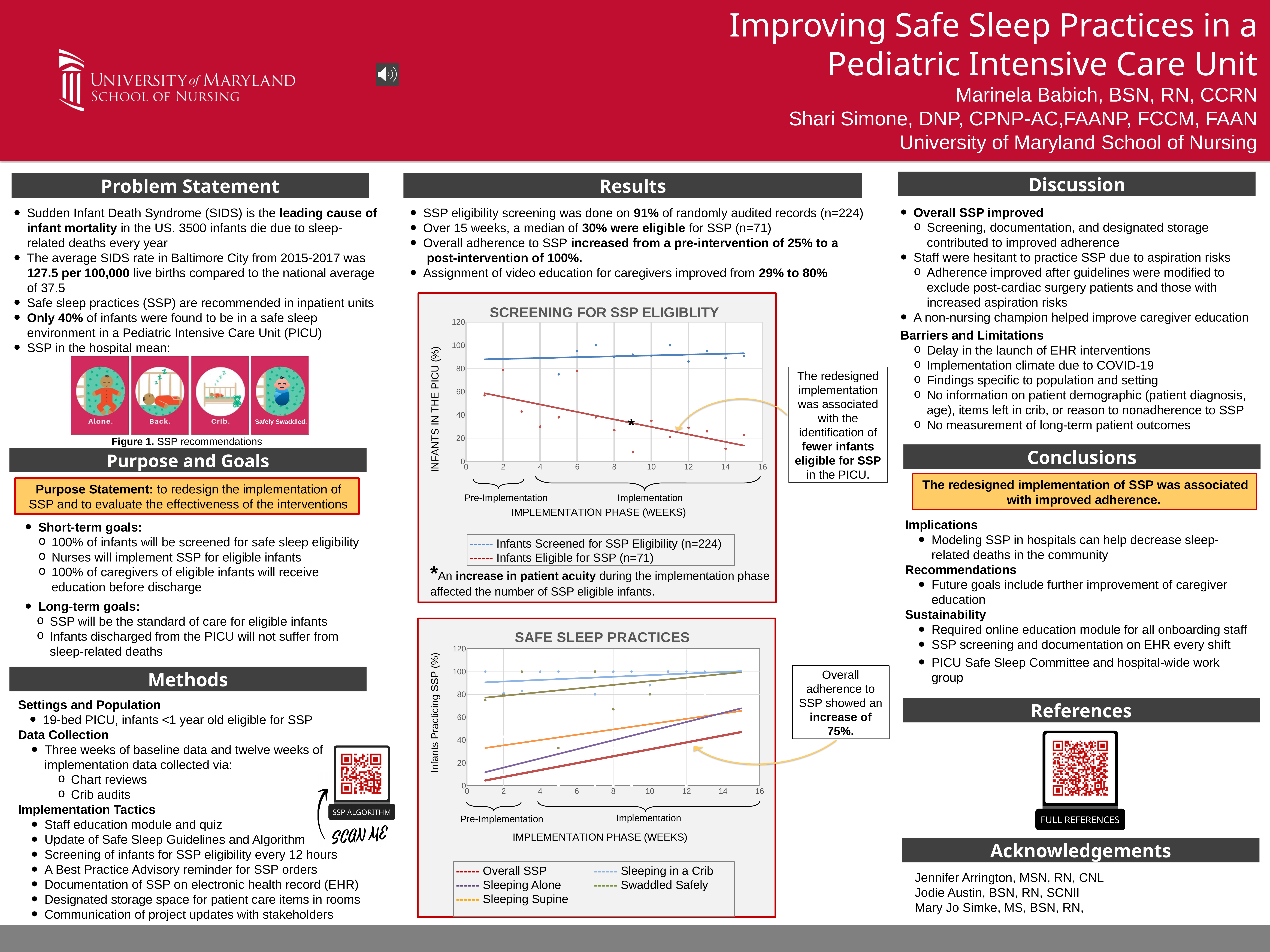
In the "SCREENING FOR SSP ELIGIBLITY" chart, does the trend line for Infants Screened for SSP Eligibility rise or fall across the implementation weeks? rise In the "SAFE SLEEP PRACTICES" chart, which series has the lowest trend line at week 1: Overall SSP or Sleeping in a Crib? Overall SSP How many series does the legend of the "SAFE SLEEP PRACTICES" chart list? 5 In the "SCREENING FOR SSP ELIGIBLITY" chart, is the trend line for Infants Eligible for SSP at week 1 greater or less than 40? greater In the "SAFE SLEEP PRACTICES" chart, does the Overall SSP trend line rise or fall across the implementation weeks? rise In the "SAFE SLEEP PRACTICES" chart, is the Overall SSP trend line at week 1 greater or less than 20? less What kind of chart is the "SCREENING FOR SSP ELIGIBLITY" chart? scatter plot with trend lines What is the x-axis label of the "SCREENING FOR SSP ELIGIBLITY" chart? IMPLEMENTATION PHASE (WEEKS) In the "SCREENING FOR SSP ELIGIBLITY" chart, which series has the higher trend line throughout: Infants Screened for SSP Eligibility or Infants Eligible for SSP? Infants Screened for SSP Eligibility In the "SCREENING FOR SSP ELIGIBLITY" chart, does the trend line for Infants Eligible for SSP rise or fall across the implementation weeks? fall How many series does the legend of the "SCREENING FOR SSP ELIGIBLITY" chart list? 2 In the "SAFE SLEEP PRACTICES" chart, is the Sleeping in a Crib trend line at week 1 greater or less than 80? greater